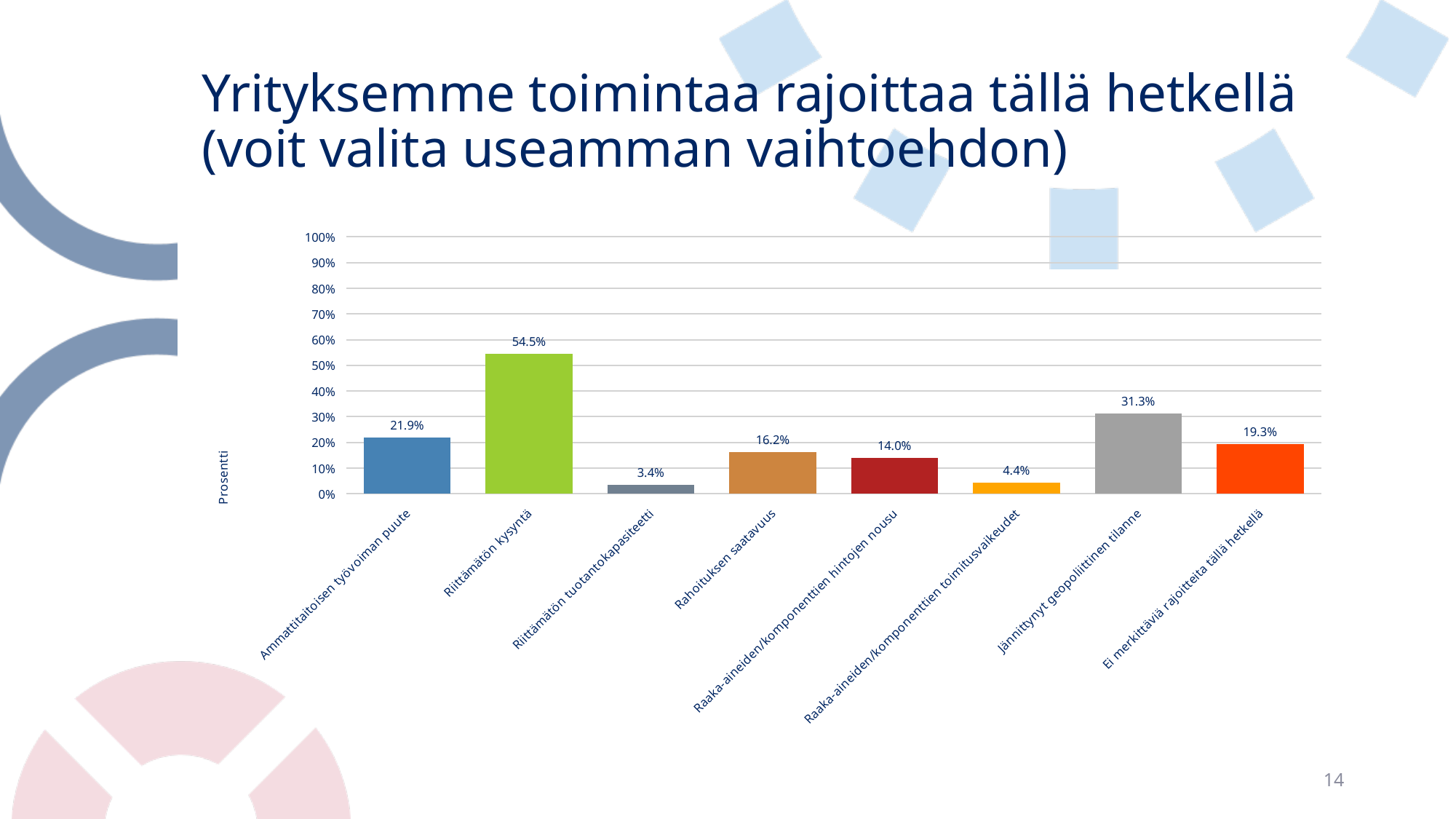
Which category has the lowest value? Riittämätön tuotantokapasiteetti Is the value for Raaka-aineiden/komponenttien hintojen nousu greater or less than 20%? less What is the value for Riittämätön kysyntä? 54.5% What is the value for Rahoituksen saatavuus? 16.2% Which is larger, the value for Ammattitaitoisen työvoiman puute or the value for Ei merkittäviä rajoitteita tällä hetkellä? Ammattitaitoisen työvoiman puute What is the difference between the values for Riittämätön kysyntä and Jännittynyt geopoliittinen tilanne? 23.2% Which category has the highest value? Riittämätön kysyntä What is the label of the vertical axis? Prosentti How many categories are shown on the x axis? 8 What kind of chart is shown on the slide? bar chart What is the value for Jännittynyt geopoliittinen tilanne? 31.3% What is the value for Ei merkittäviä rajoitteita tällä hetkellä? 19.3%